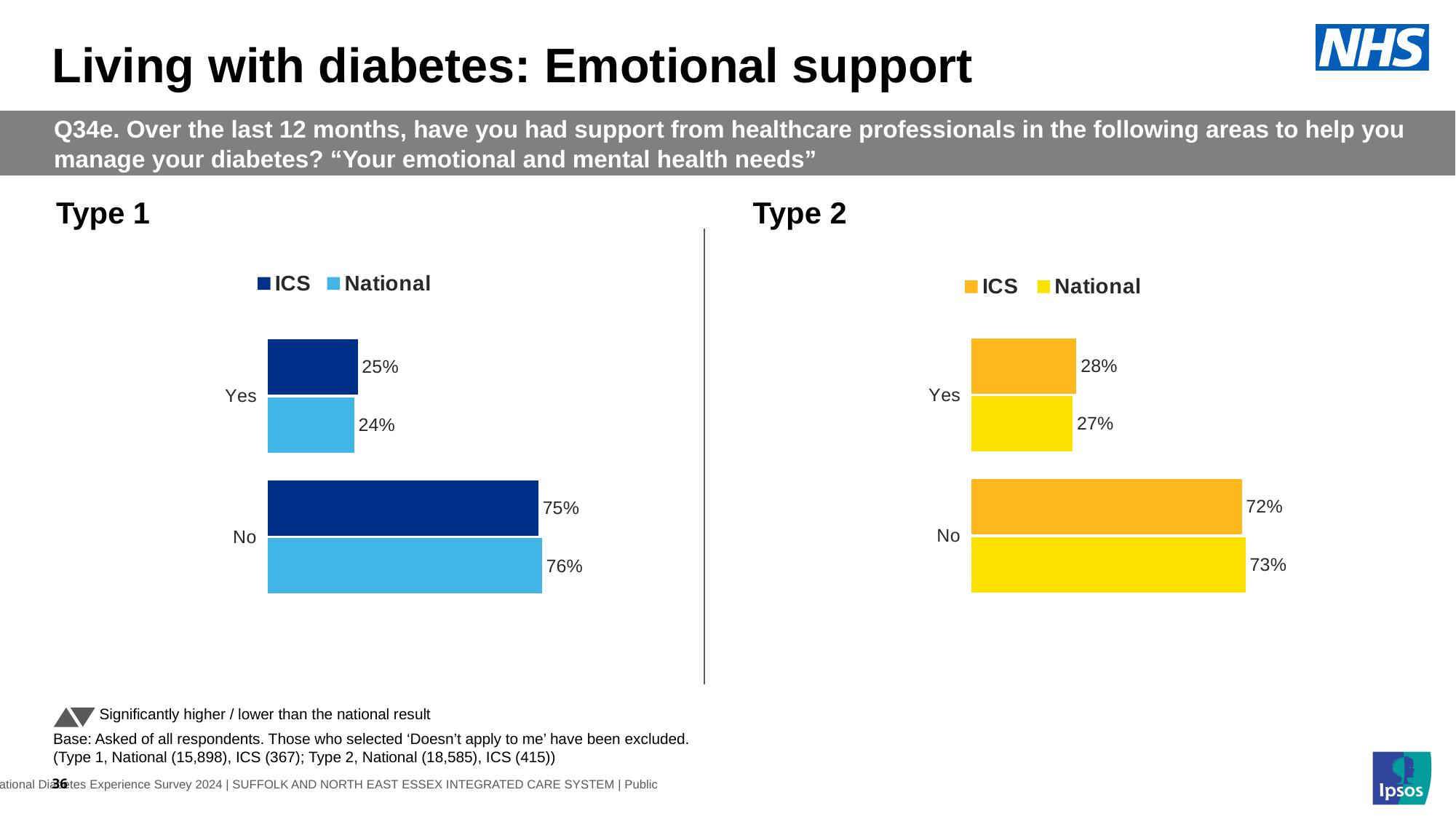
In the Type 1 chart, is the ICS value for No larger or smaller than the ICS value for Yes? larger What kind of chart is the Type 1 chart? bar chart In the Type 2 chart, what is the difference between the National and ICS values for No? 1% In the Type 2 chart, what is the National value for No? 73% In the Type 1 chart, what is the difference between the ICS and National values for Yes? 1% In the Type 1 chart, what is the ICS value for Yes? 25% In the Type 2 chart, what colour are the National bars? yellow In the Type 2 chart, what is the ICS value for Yes? 28% In the Type 1 chart, which category has the lowest National value? Yes In the Type 1 chart, what is the National value for No? 76% How many series does the legend of the Type 2 chart list? 2 In the Type 2 chart, which category has the highest ICS value? No